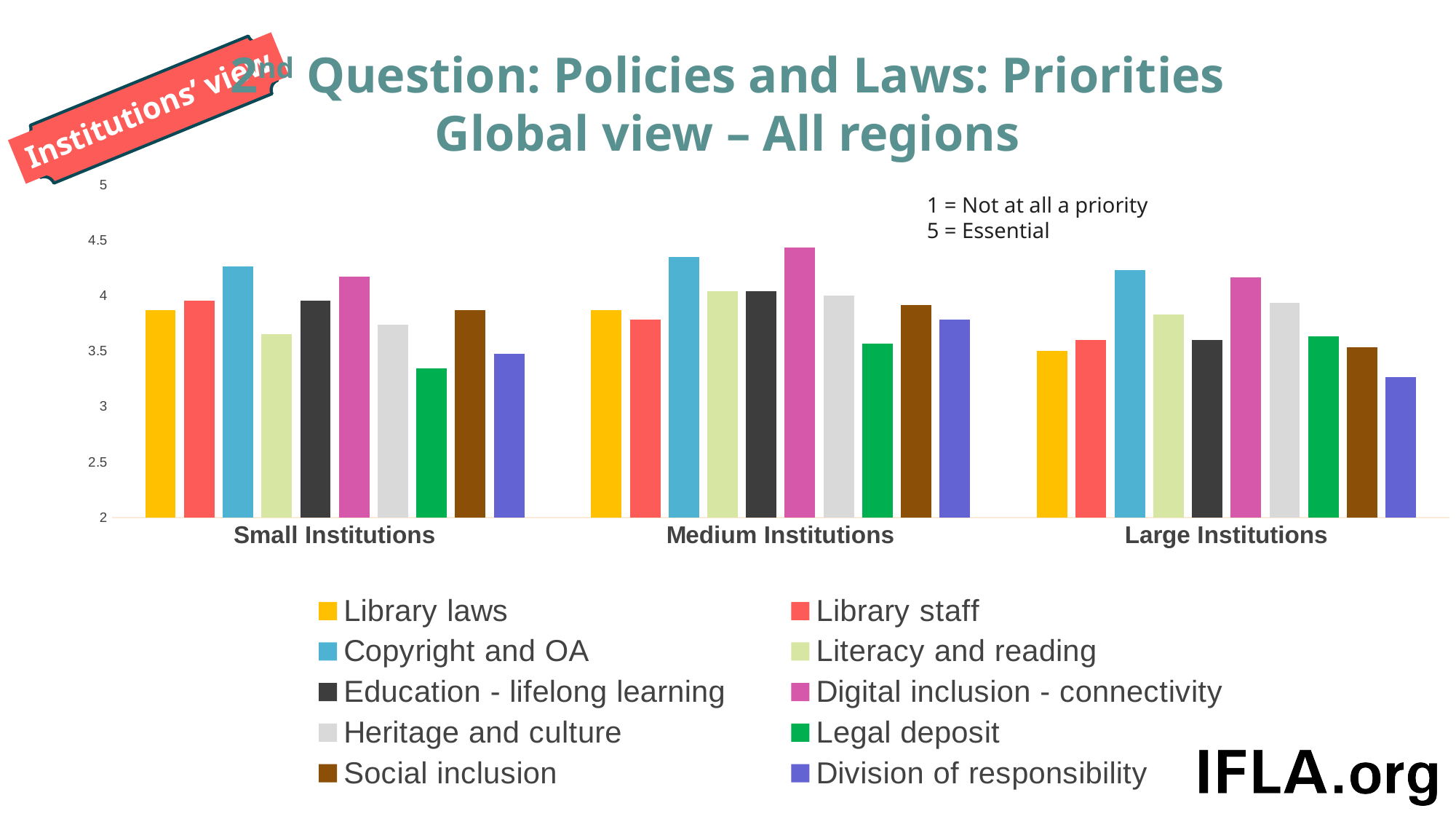
For Library laws, which is larger: the value for Small Institutions or for Large Institutions? Small Institutions Which series has the lowest value for Small Institutions? Legal deposit Which series has the lowest value for Large Institutions? Division of responsibility According to the note on the chart, what does a rating of 5 mean? Essential Which series has the highest value for Small Institutions? Copyright and OA Is the value for Division of responsibility at Large Institutions greater or less than 3.5? less Which series has the highest value for Medium Institutions? Digital inclusion - connectivity What kind of chart is shown on the slide? bar chart For Large Institutions, which is larger: Copyright and OA or Library laws? Copyright and OA How many series does the legend list? 10 Is the value for Copyright and OA at Small Institutions greater or less than 4? greater How many institution-size categories are shown on the x axis? 3